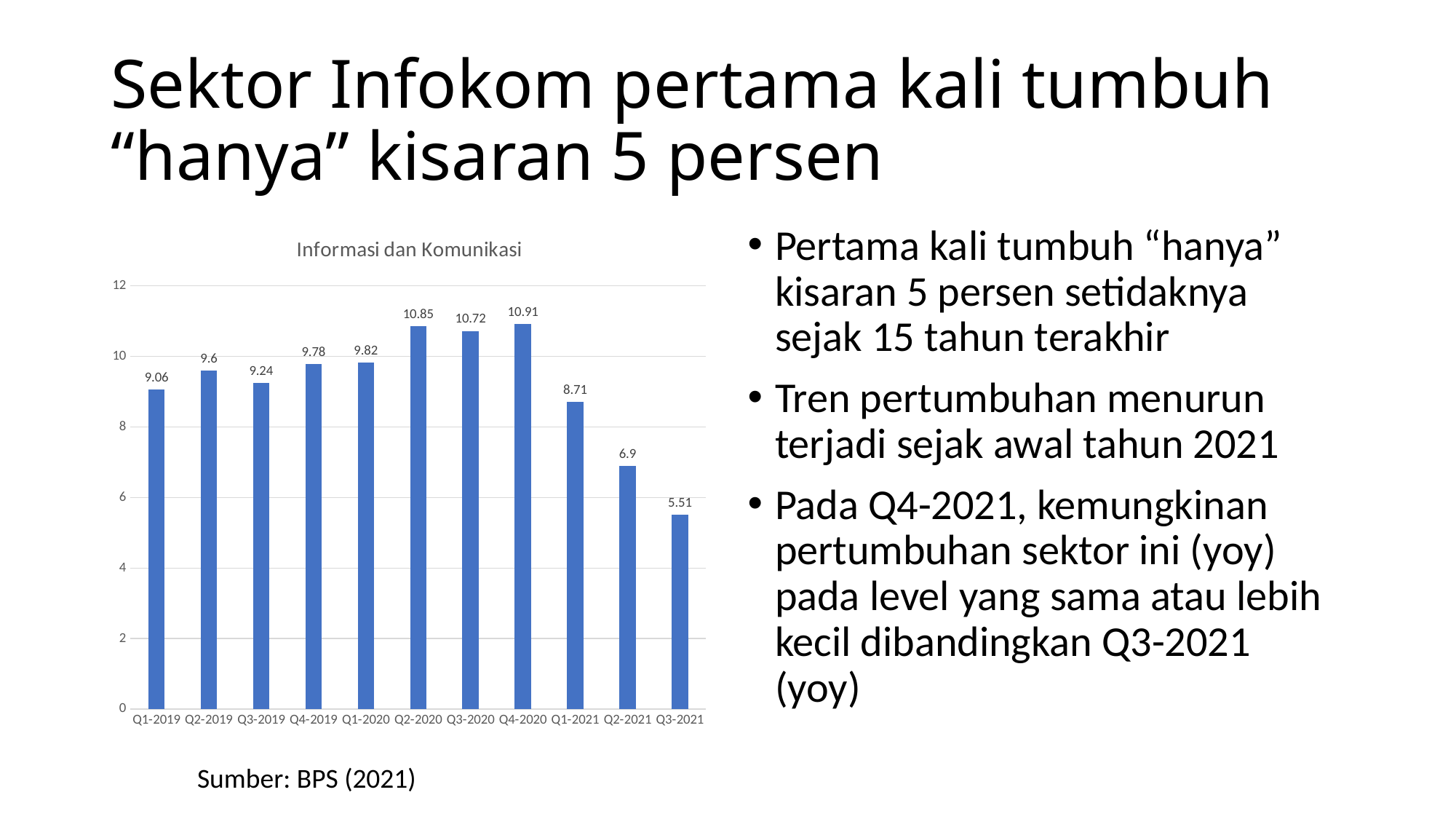
What is the value for Q2-2020? 10.85 Is the value for Q2-2021 greater or less than 8? less What is the value for Q3-2021? 5.51 Do the values rise or fall from Q4-2020 to Q3-2021? fall How many quarters are shown on the x axis? 11 Which quarter has the highest value? Q4-2020 What is the value for Q1-2019? 9.06 What is the difference between the values for Q4-2020 and Q3-2021? 5.4 What kind of chart is shown? bar chart Which is larger, the value for Q2-2019 or the value for Q3-2019? Q2-2019 Which quarter has the lowest value? Q3-2021 What is the title of the chart? Informasi dan Komunikasi